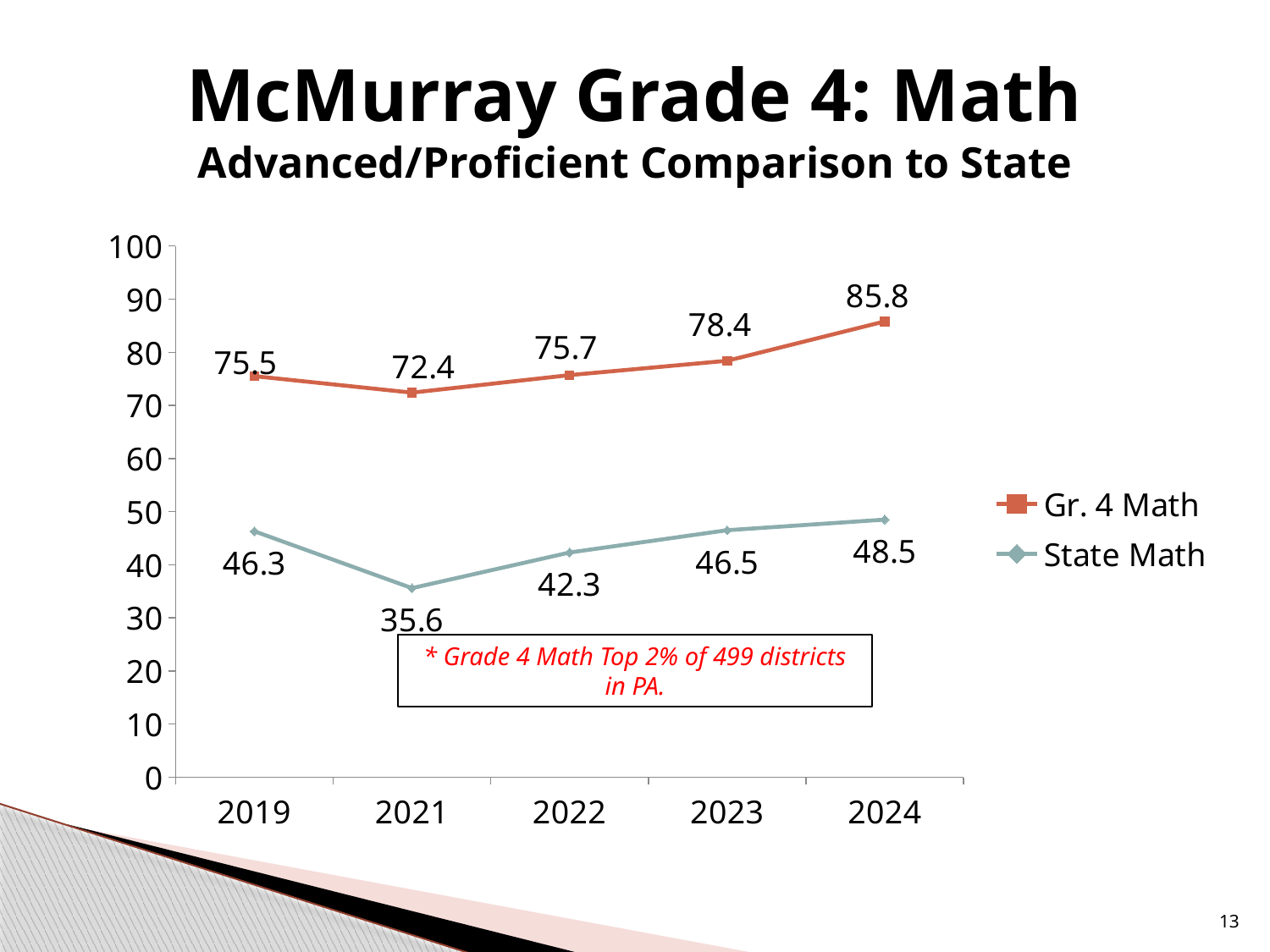
In which year is the Gr. 4 Math value highest? 2024 What is the difference between the Gr. 4 Math values for 2023 and 2022? 2.7 Does the Gr. 4 Math series rise or fall from 2021 to 2024? Rise In which year is the State Math value lowest? 2021 How many series does the legend list? 2 What is the Gr. 4 Math value for 2024? 85.8 Which is larger in 2022, Gr. 4 Math or State Math? Gr. 4 Math What is the Gr. 4 Math value for 2019? 75.5 How many years are shown on the x axis? 5 What is the State Math value for 2021? 35.6 What is the difference between Gr. 4 Math and State Math in 2024? 37.3 What kind of chart is shown on the slide? Line chart